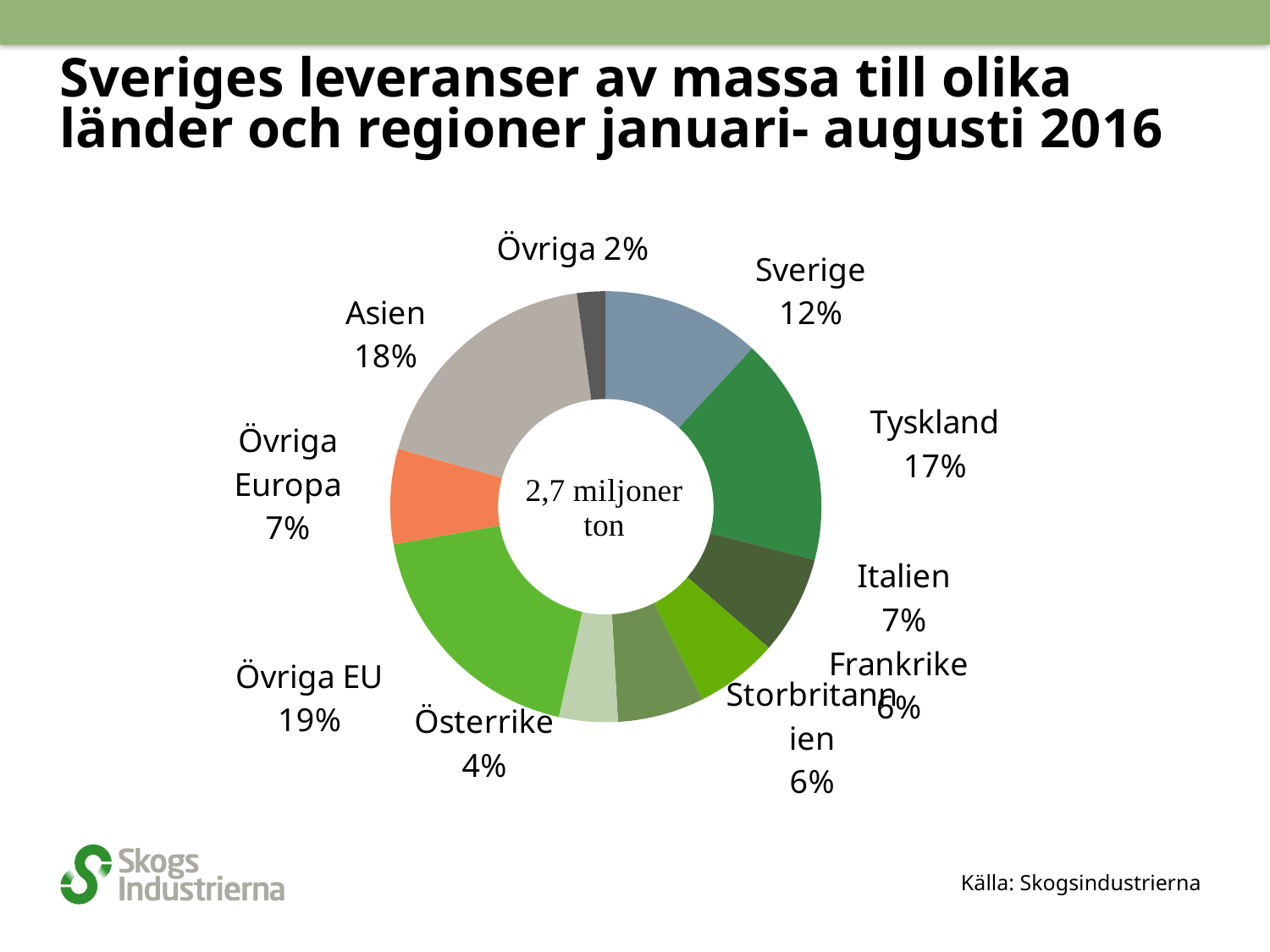
What percentage is shown for Asien? 18% How many categories are shown in the chart? 10 Which category has the largest share of the pie? Övriga EU What is the difference in percentage points between Tyskland and Sverige? 5 What kind of chart is shown on the slide? Pie chart (doughnut) Which is larger, the share for Italien or the share for Frankrike? Italien What total quantity is printed in the centre of the chart? 2,7 miljoner ton What share of deliveries went to Tyskland? 17% What is the source cited at the bottom of the slide? Skogsindustrierna What share is labelled for Österrike? 4% Which category has the smallest share of the pie? Övriga What is the combined share of Storbritannien and Frankrike? 12%